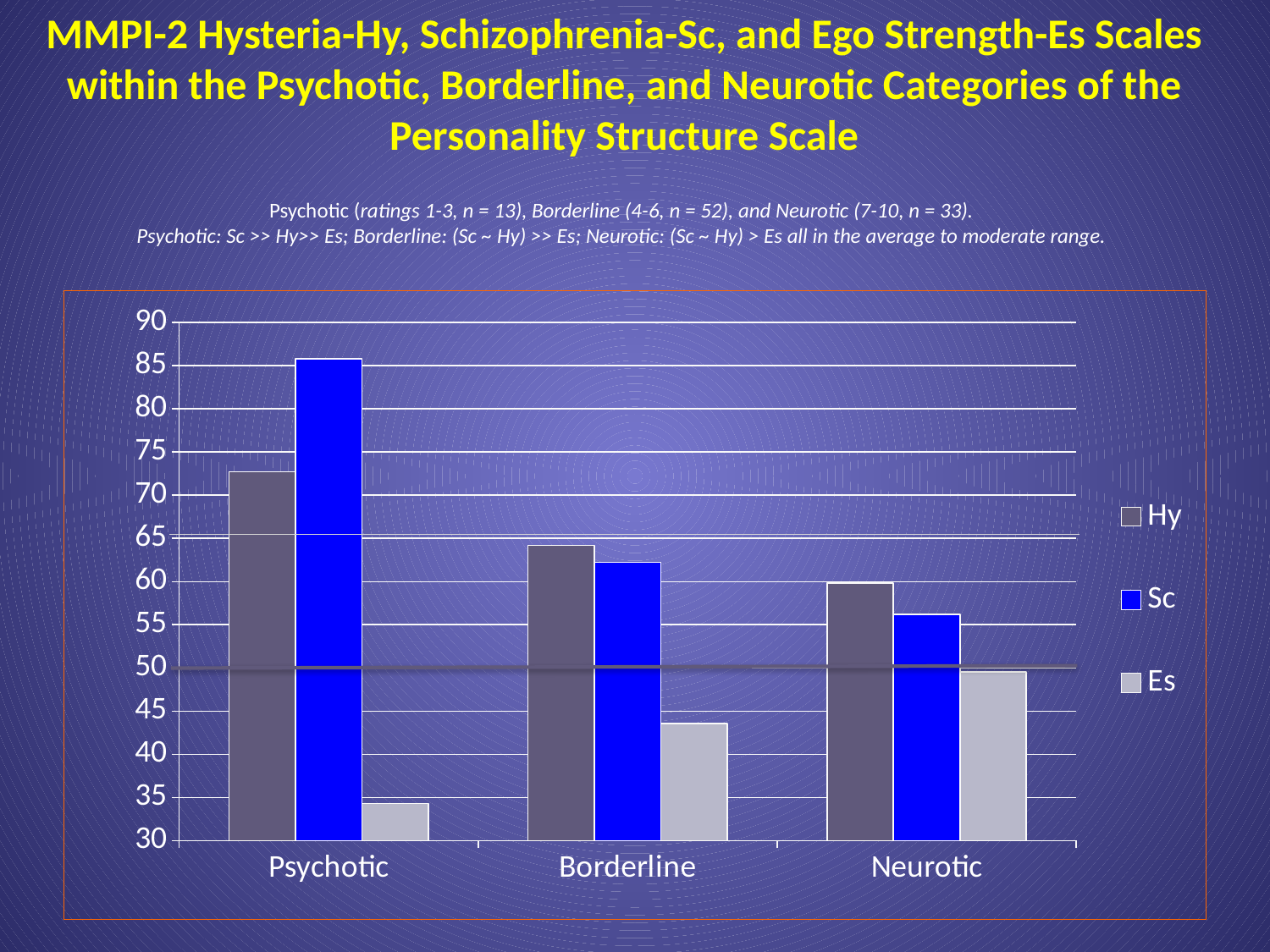
In the Neurotic category, which is larger, Hy or Sc? Hy Which series and category has the tallest bar in the chart? Sc in Psychotic Which series and category has the shortest bar in the chart? Es in Psychotic How many series does the chart's legend list? 3 In the Psychotic category, which is larger, Hy or Sc? Sc Is the value for Hy in the Neurotic category greater or less than 55? greater How many categories are shown on the x axis of the chart? 3 What kind of chart is shown on the slide? bar chart Is the value for Sc in the Psychotic category greater or less than 80? greater Do the Sc values rise or fall from Psychotic to Neurotic along the x axis? fall Is the value for Es in the Psychotic category greater or less than 40? less